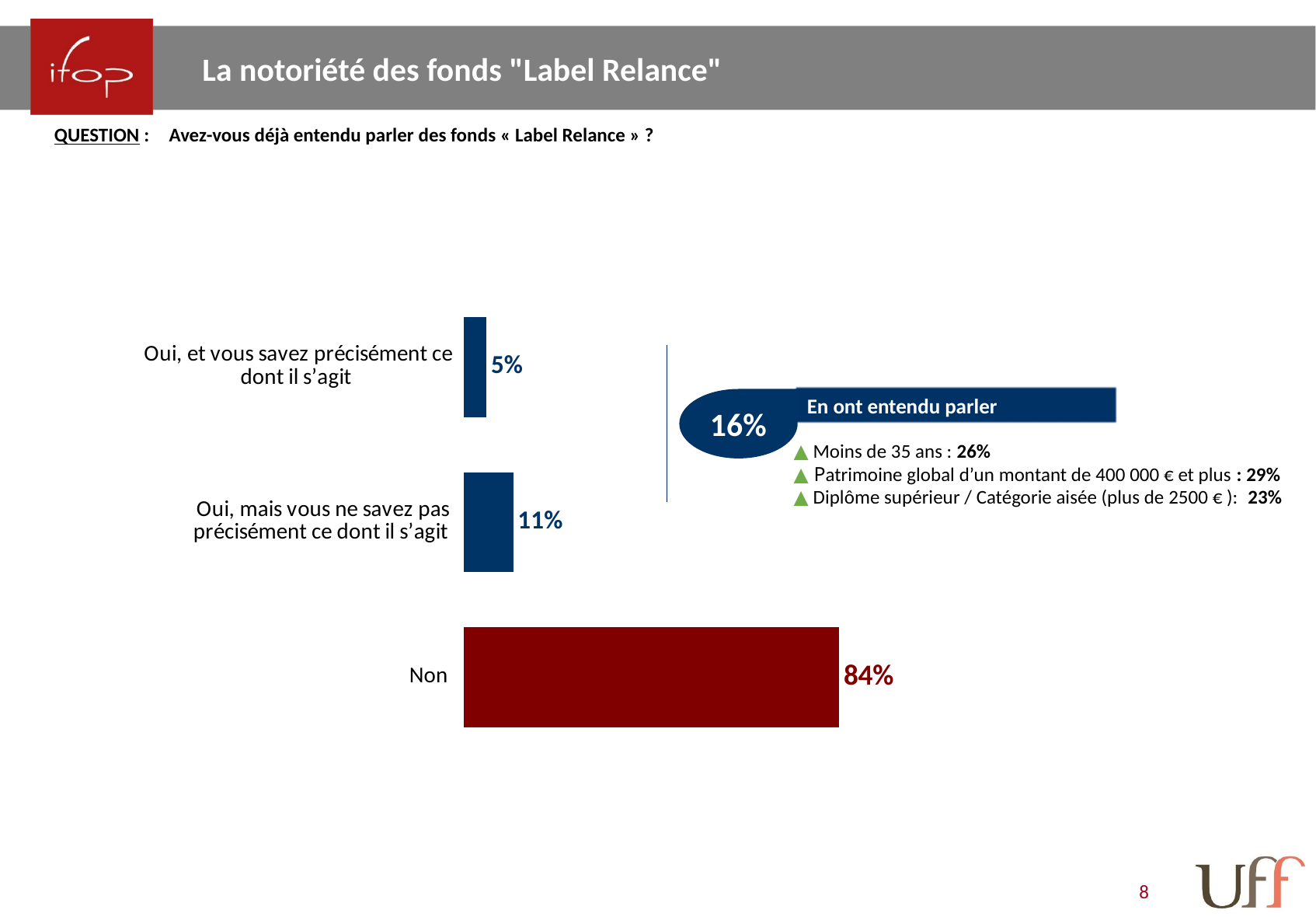
What is the value for "Oui, mais vous ne savez pas précisément ce dont il s'agit"? 11% What percentage is shown in the circle labelled "En ont entendu parler"? 16% What is the value for "Non"? 84% What colour is the bar for "Non"? Dark red What is the combined value of the two "Oui" categories? 16% Which category has the highest value? Non What kind of chart is shown on the slide? Bar chart Which is larger: the value for "Oui, et vous savez précisément ce dont il s'agit" or the value for "Oui, mais vous ne savez pas précisément ce dont il s'agit"? Oui, mais vous ne savez pas précisément ce dont il s'agit What is the value for "Oui, et vous savez précisément ce dont il s'agit"? 5% How many categories are shown in the chart? 3 What is the difference between the value for "Non" and the value for "Oui, mais vous ne savez pas précisément ce dont il s'agit"? 73% Which category has the lowest value? Oui, et vous savez précisément ce dont il s'agit